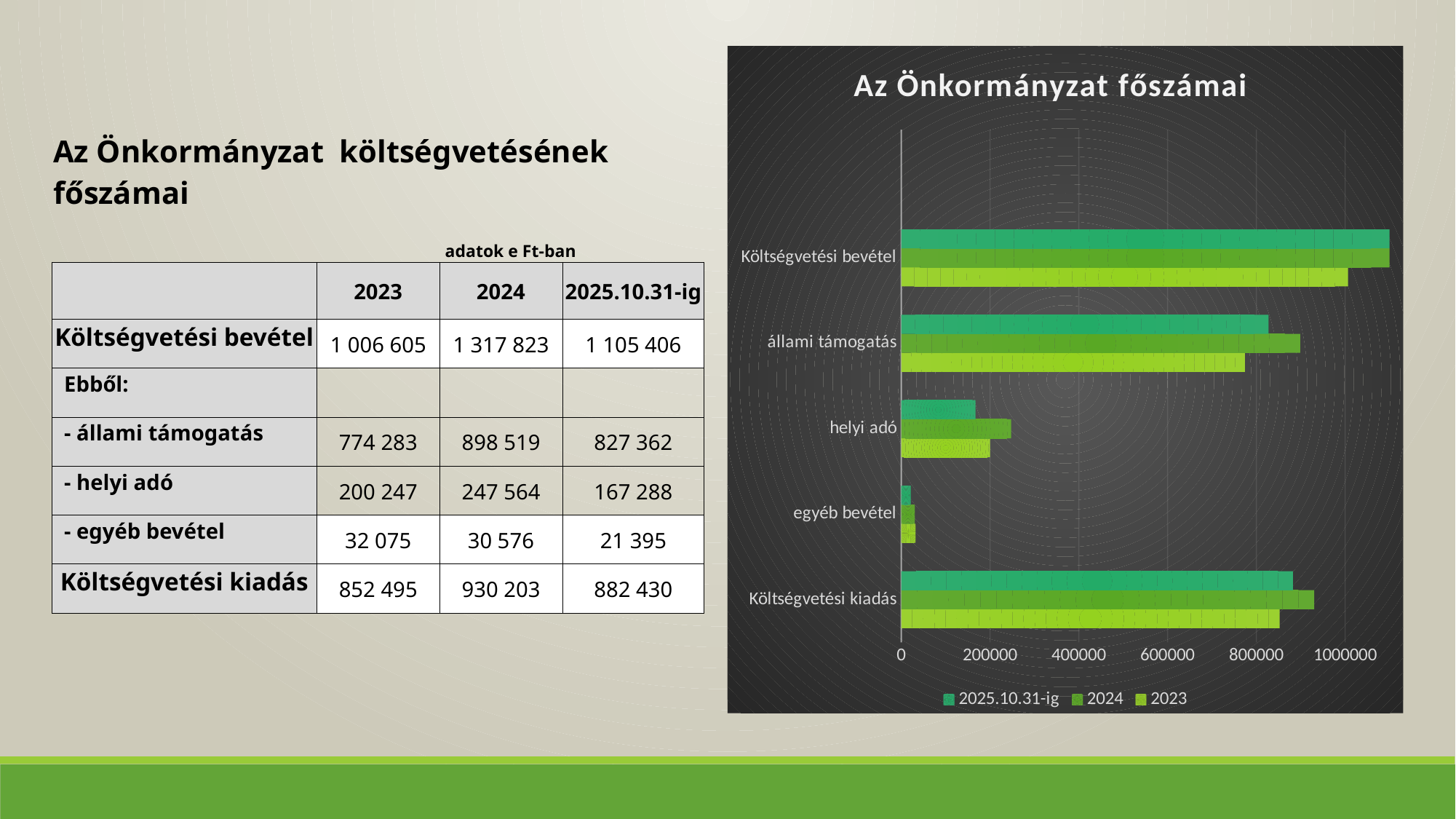
For the 2024 series, which is larger: Költségvetési bevétel or Költségvetési kiadás? Költségvetési bevétel How many series does the legend of the chart list? 3 For állami támogatás, which series has the longer bar: 2024 or 2025.10.31-ig? 2024 Is the 2024 value for helyi adó greater or less than 200000? greater What kind of chart is shown on the slide? bar chart What are the three entries in the chart's legend? 2025.10.31-ig, 2024, 2023 Which category has the longest bar for the 2024 series? Költségvetési bevétel Which category has the shortest bars on the chart? egyéb bevétel How many categories are plotted on the chart 'Az Önkormányzat főszámai'? 5 What is the value of helyi adó for 2023? 200 247 What is the difference between the Költségvetési bevétel values for 2024 and 2023? 311 218 Is the 2023 value for állami támogatás greater or less than 800000? less